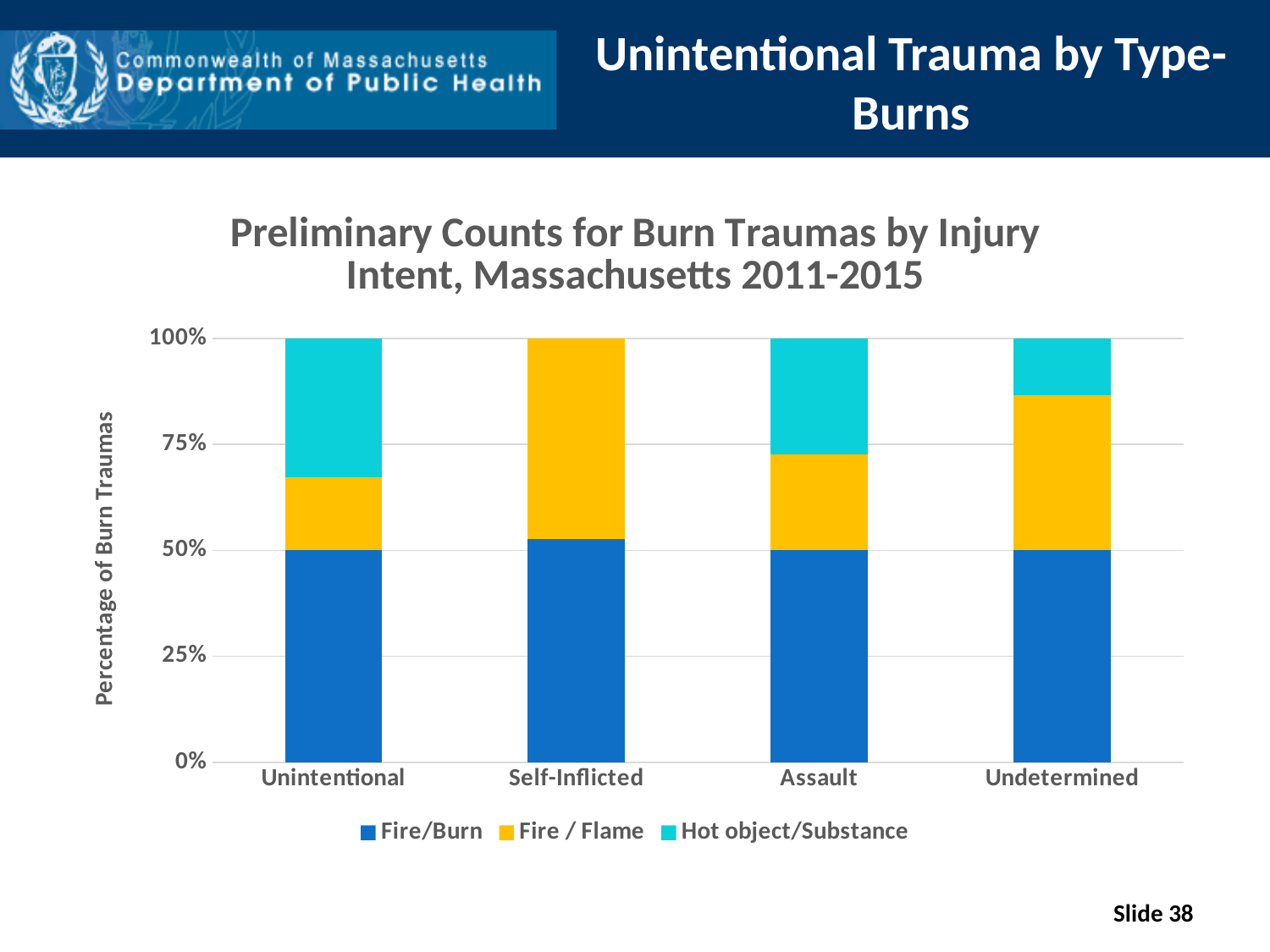
How many injury intent categories are shown on the x axis? 4 What is the label of the y axis? Percentage of Burn Traumas How many series does the legend list? 3 Which category has the largest Hot object/Substance segment? Unintentional What kind of chart is shown on the slide? Stacked bar chart Which category has the smallest Hot object/Substance segment? Self-Inflicted Is the Fire/Burn value for Self-Inflicted greater or less than 50%? greater What is the title of the chart? Preliminary Counts for Burn Traumas by Injury Intent, Massachusetts 2011-2015 What is the total height of the stacked bar for Assault? 100% What is the Fire/Burn value for Unintentional? 50% Is the Hot object/Substance share for Undetermined greater or less than 25%? less Which has the larger Fire / Flame segment, Self-Inflicted or Unintentional? Self-Inflicted